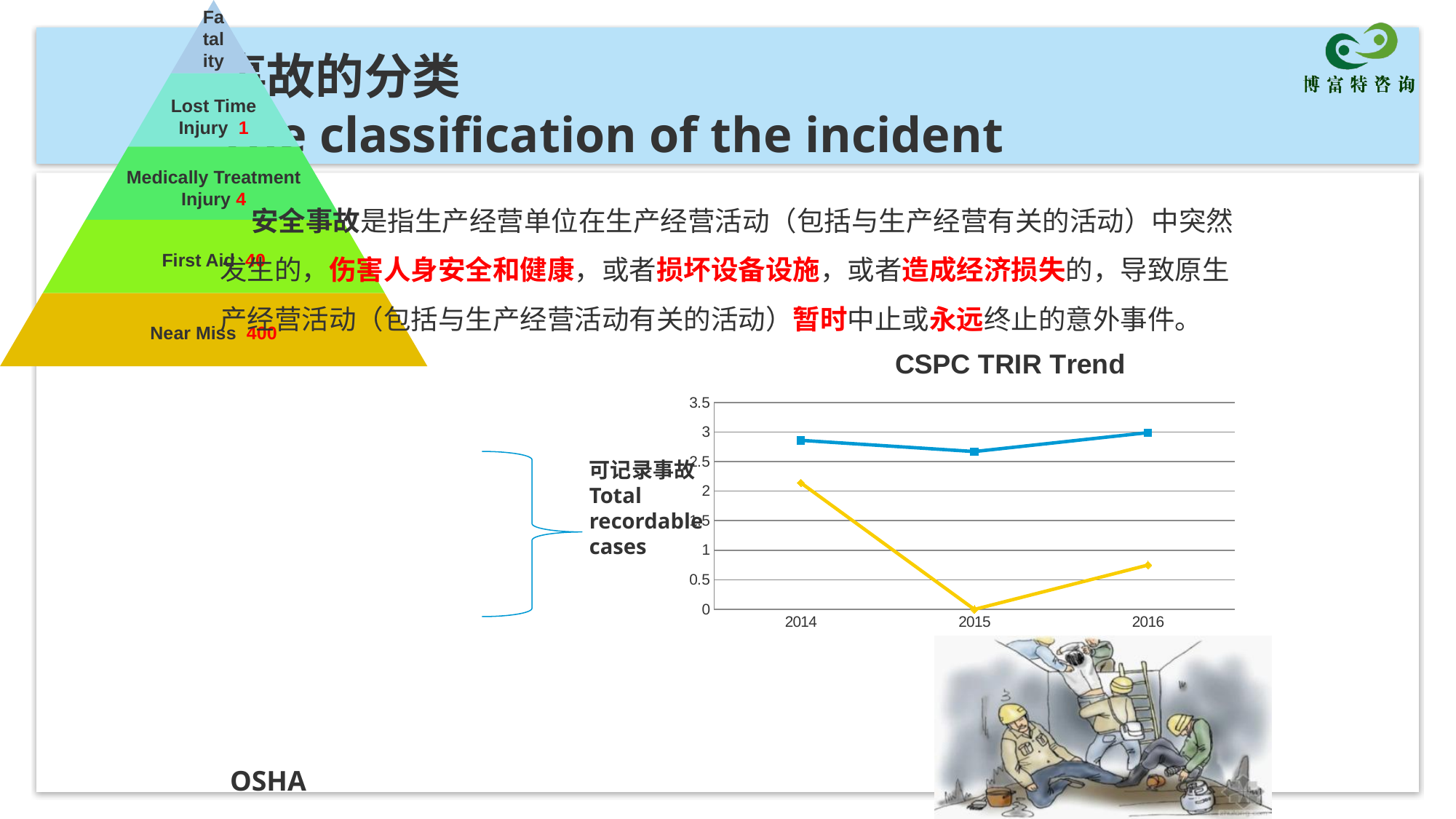
In the CSPC TRIR Trend chart, is the value of the blue line for 2014 greater or less than 2.5? greater In the CSPC TRIR Trend chart, which line has the larger value in 2015, the blue line or the yellow line? the blue line In the CSPC TRIR Trend chart, is the value of the blue line for 2015 greater or less than 2.5? greater What kind of chart is the CSPC TRIR Trend chart? line chart In the CSPC TRIR Trend chart, in which year is the yellow line at its highest? 2014 How many years are plotted along the x axis of the CSPC TRIR Trend chart? 3 What is the title of the chart on the slide? CSPC TRIR Trend In the CSPC TRIR Trend chart, does the yellow line rise or fall from 2014 to 2015? fall In the CSPC TRIR Trend chart, what is the value of the yellow line for 2015? 0 In the CSPC TRIR Trend chart, is the value of the yellow line for 2016 greater or less than 1? less In the CSPC TRIR Trend chart, in which year is the yellow line at its lowest? 2015